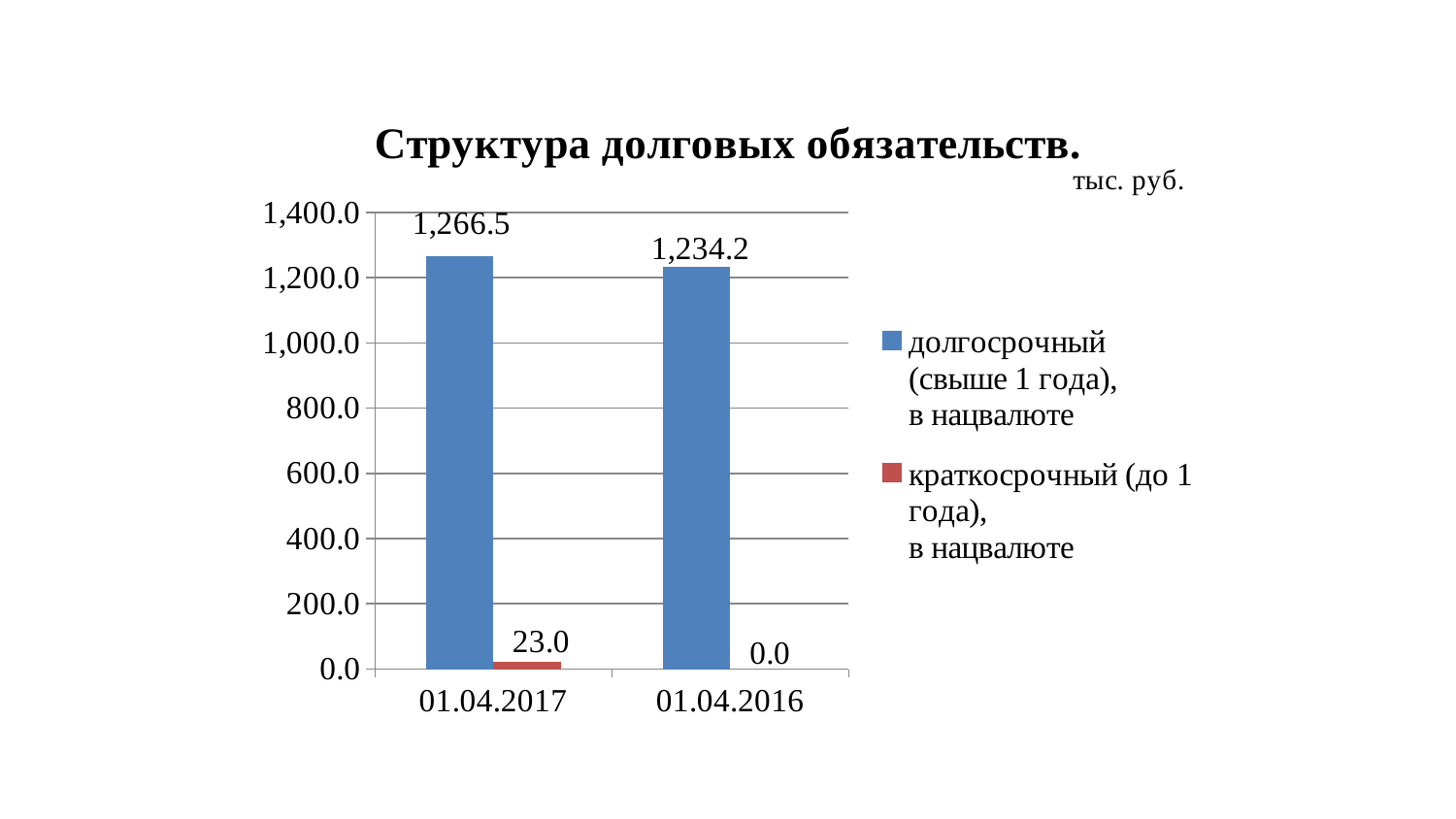
Which date has the higher value for долгосрочный (свыше 1 года), в нацвалюте? 01.04.2017 What is the value of краткосрочный (до 1 года), в нацвалюте for 01.04.2016? 0.0 What is the title of the chart? Структура долговых обязательств. What is the value of краткосрочный (до 1 года), в нацвалюте for 01.04.2017? 23.0 What is the difference between the долгосрочный values for 01.04.2017 and 01.04.2016? 32.3 How many categories (dates) are shown on the x axis? 2 What kind of chart is shown on the slide? bar chart What is the value of долгосрочный (свыше 1 года), в нацвалюте for 01.04.2017? 1,266.5 What is the value of долгосрочный (свыше 1 года), в нацвалюте for 01.04.2016? 1,234.2 Is the долгосрочный value for 01.04.2016 greater or less than 1,200.0? greater How many series does the legend list? 2 What unit is indicated for the chart values? тыс. руб.